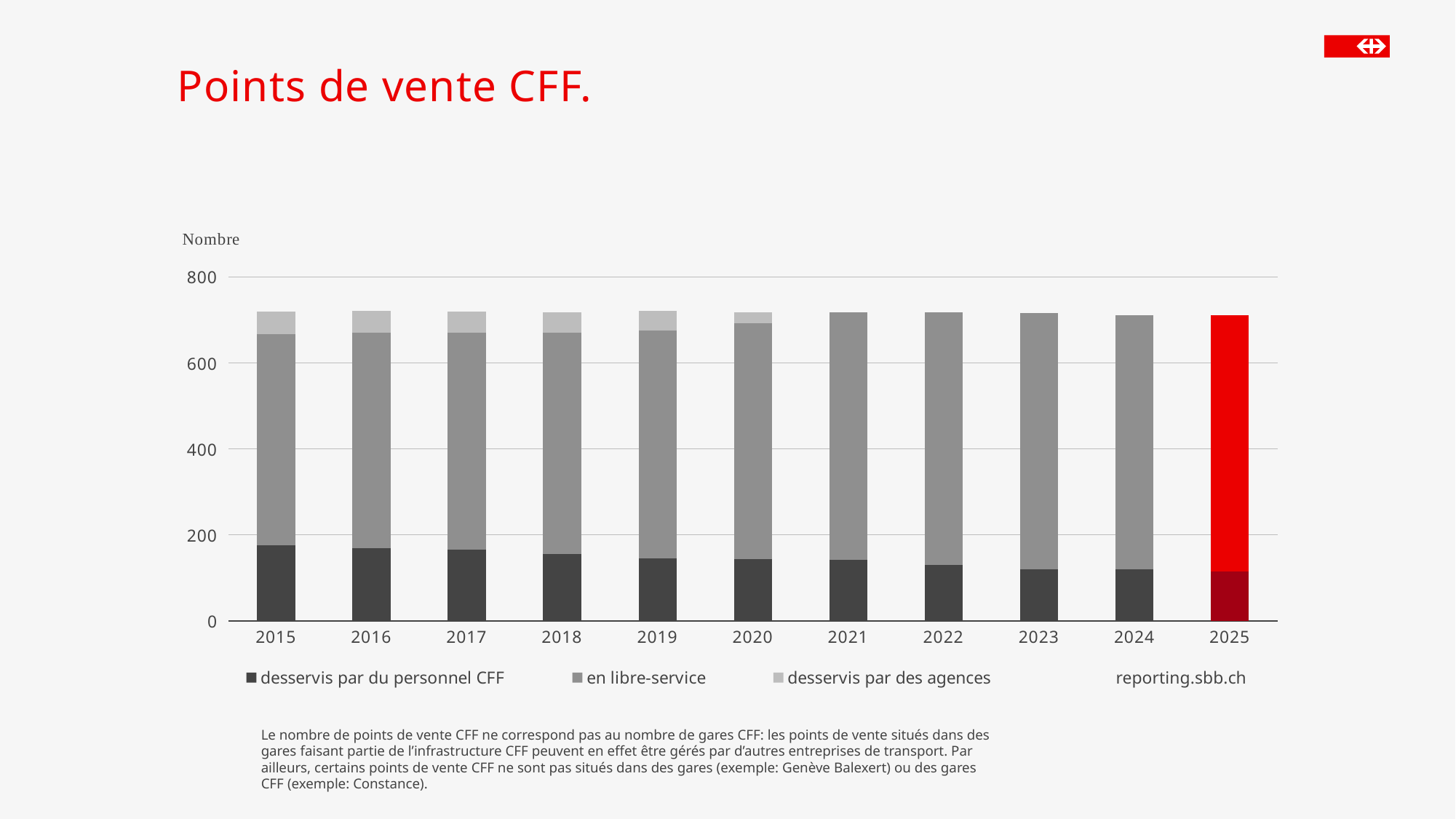
What colour is the bar for 2025 in the chart? red Is the value for 'desservis par du personnel CFF' in 2015 greater or less than 200? less What kind of chart is shown on the slide? bar chart How many series does the chart legend list? 3 Is the total height of the stacked bar for 2015 greater or less than 600? greater How many years are shown on the x axis of the chart? 11 What is the title of the chart on the slide? Points de vente CFF. Does the 'desservis par du personnel CFF' series rise or fall from 2015 to 2025? fall Is the total height of the stacked bar for 2025 greater or less than 800? less Which is larger, the 'desservis par du personnel CFF' value in 2015 or in 2024? 2015